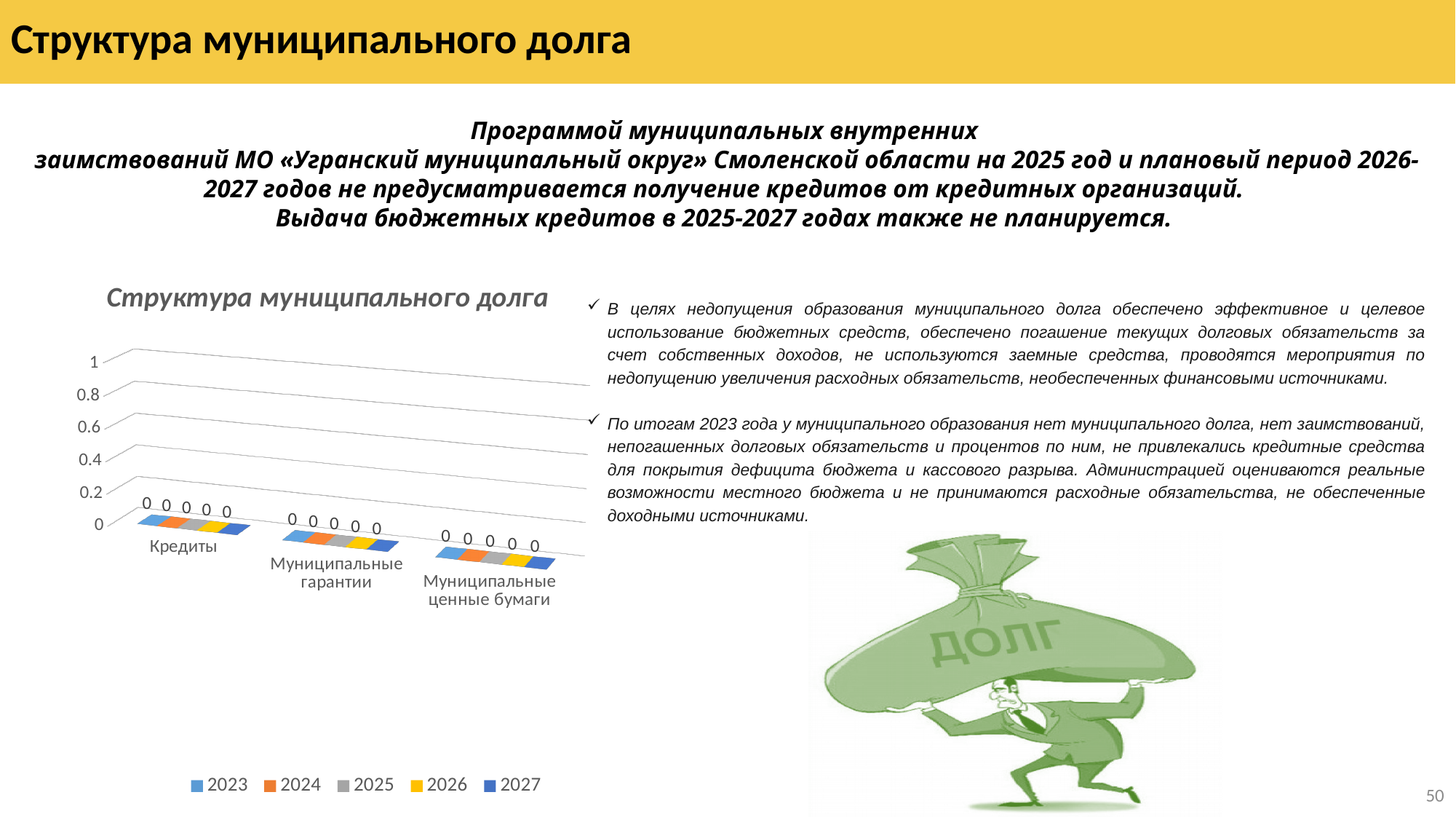
What is the total of all five years' values for Муниципальные ценные бумаги? 0 Which years are listed in the chart legend? 2023, 2024, 2025, 2026, 2027 How many categories are shown on the x axis of the chart? 3 What is the value for Муниципальные гарантии in 2025? 0 What is the difference between the 2023 and 2027 values for Кредиты? 0 What is the title of the chart? Структура муниципального долга What is the value for Кредиты in 2023? 0 What is the value for Муниципальные ценные бумаги in 2027? 0 What is the value for Кредиты in 2026? 0 Is the value for Муниципальные гарантии in 2024 greater or less than 0.2? less How many series does the chart legend list? 5 What kind of chart is shown on the slide? bar chart